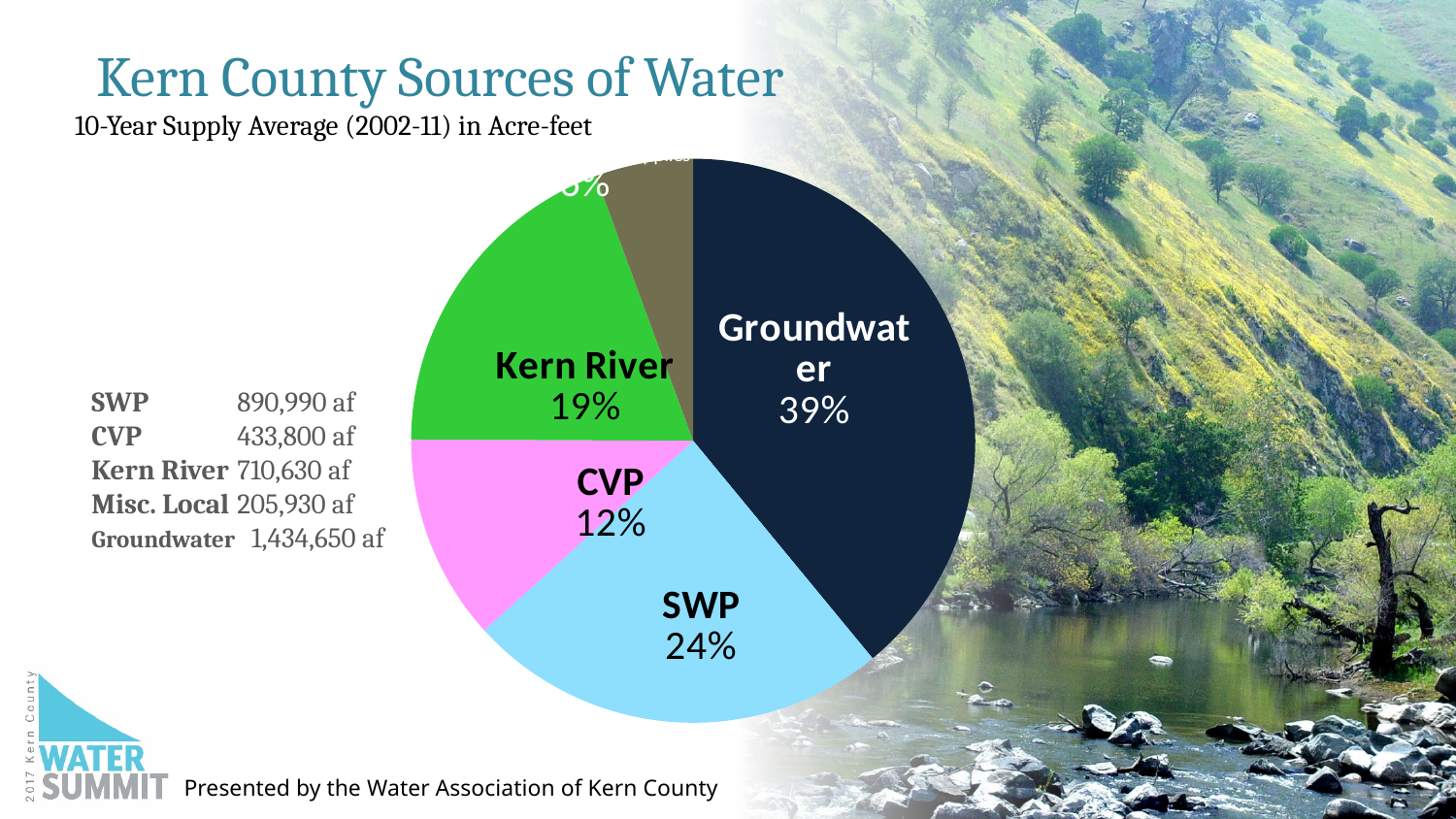
What percentage of the pie does Groundwater represent? 39% Which is larger, the CVP slice or the Kern River slice? Kern River Which water source has the largest slice of the pie? Groundwater How many slices does the pie chart have? 5 What percentage of the pie does CVP represent? 12% What is the subtitle shown under the chart title? 10-Year Supply Average (2002-11) in Acre-feet What percentage of the pie does SWP represent? 24% Which is larger, the SWP slice or the Kern River slice? SWP What kind of chart is shown on the slide? Pie chart What is the title of the chart on the slide? Kern County Sources of Water What is the difference in percentage points between the Groundwater slice and the SWP slice? 15